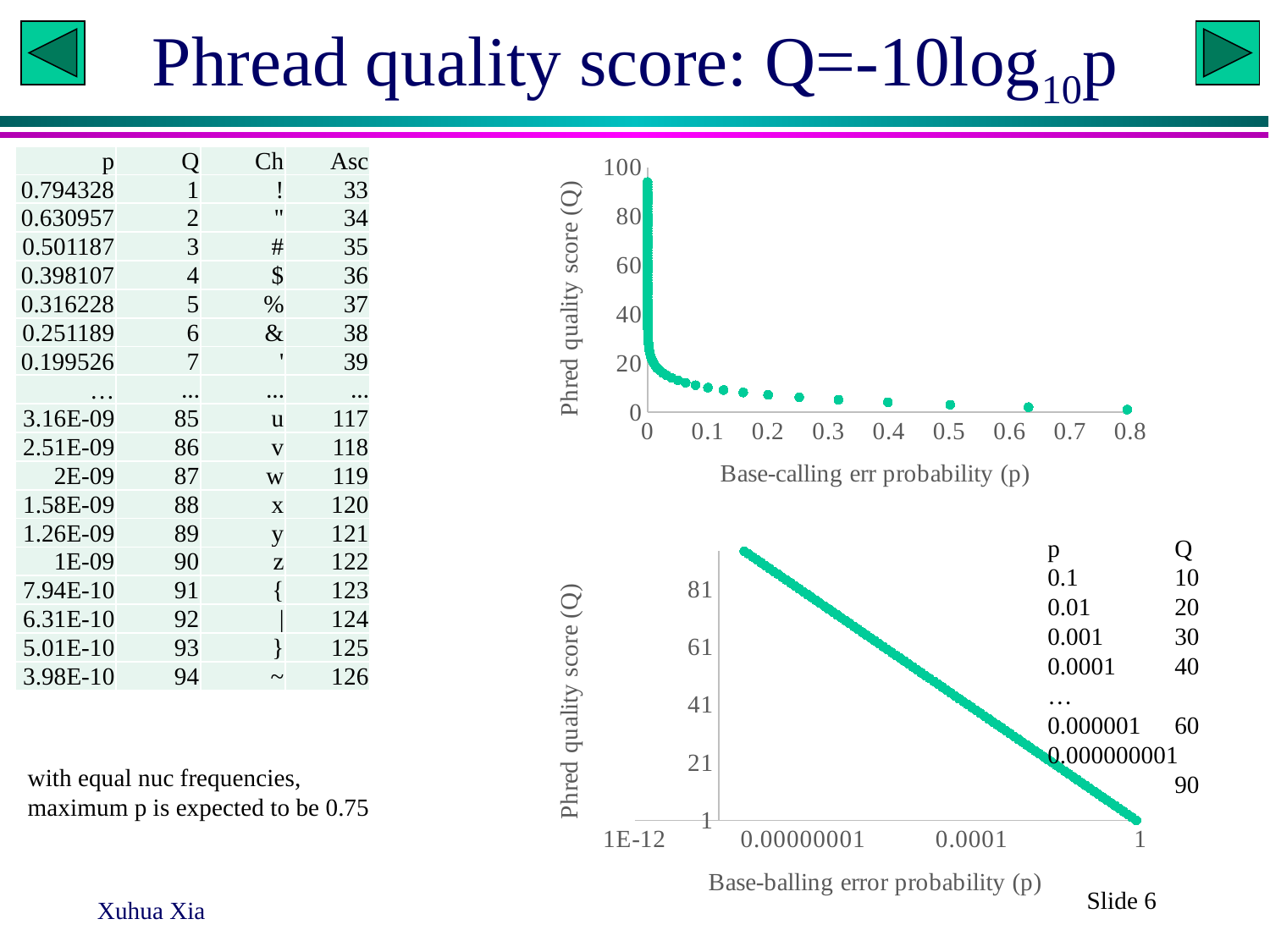
In the top chart, is the highest plotted Phred quality score (near p = 0) greater or less than 80? greater What kind of chart is the top chart on the slide? scatter chart In the top chart, does the Phred quality score rise or fall as the base-calling error probability increases along the x axis? fall In the bottom chart, is the Phred quality score at p = 0.00000001 greater or less than 61? greater In the top chart, which has the larger Phred quality score: p = 0.1 or p = 0.5? p = 0.1 In the top chart, is the Phred quality score at p = 0.1 greater or less than 20? less In the bottom chart, does the Phred quality score rise or fall as the error probability increases along the x axis? fall What is the y-axis title of the bottom chart? Phred quality score (Q) What kind of chart is the bottom chart on the slide? scatter chart What is the x-axis title of the top chart? Base-calling err probability (p)